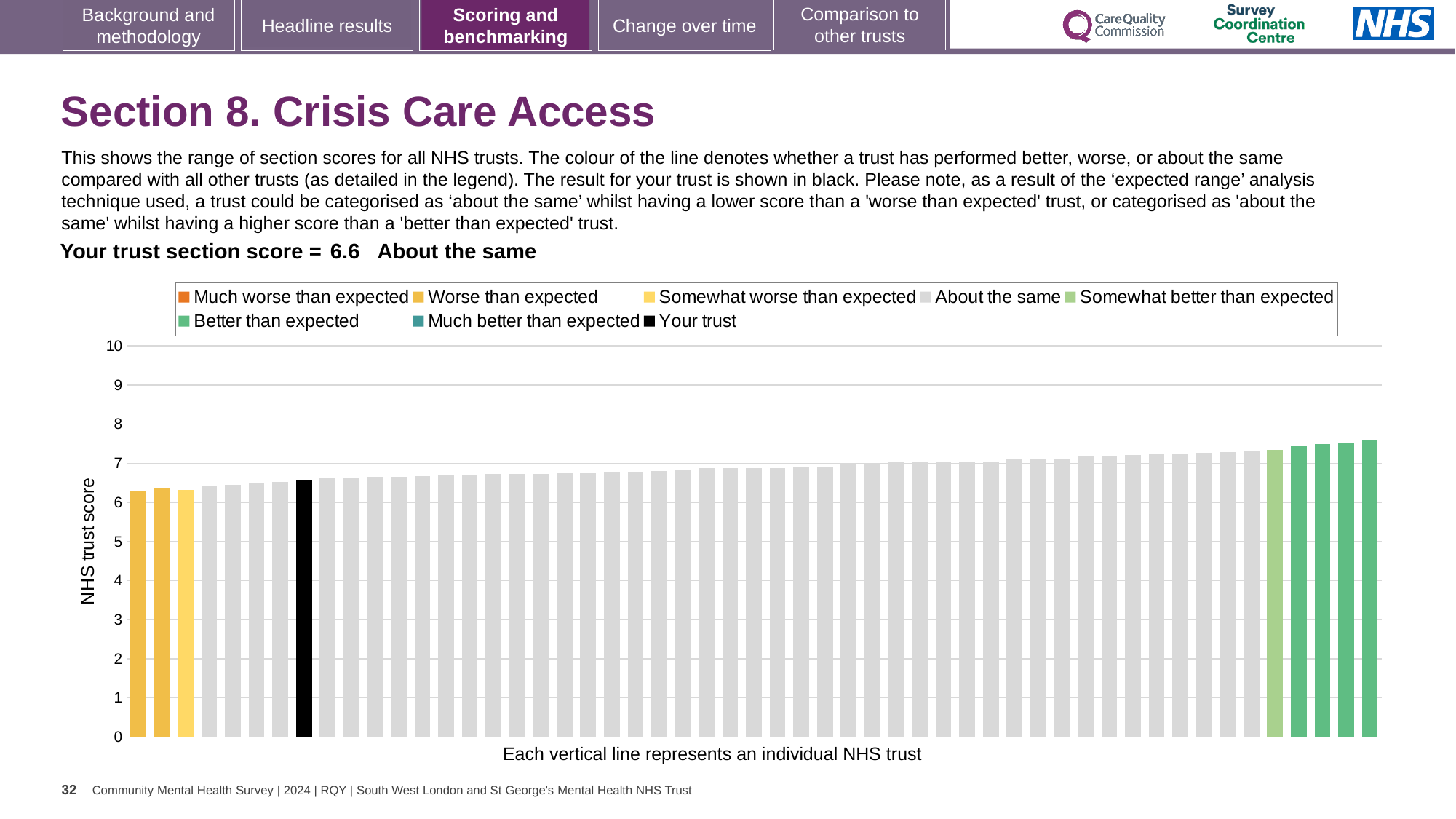
Which legend category do the highest bars on the right of the chart belong to? Better than expected What is the label on the vertical axis of the chart? NHS trust score How many entries does the chart legend list? 8 Is the value of the lowest bar in the chart greater or less than 6? greater Is the value of the highest bar in the chart greater or less than 8? less Is the value for your trust (the black bar) greater or less than 6? greater What is the section score for your trust shown on the slide? 6.6 How many bars are coloured as 'Worse than expected'? 2 Do the bar values rise or fall from left to right across the chart? rise What kind of chart is shown on the slide? bar chart